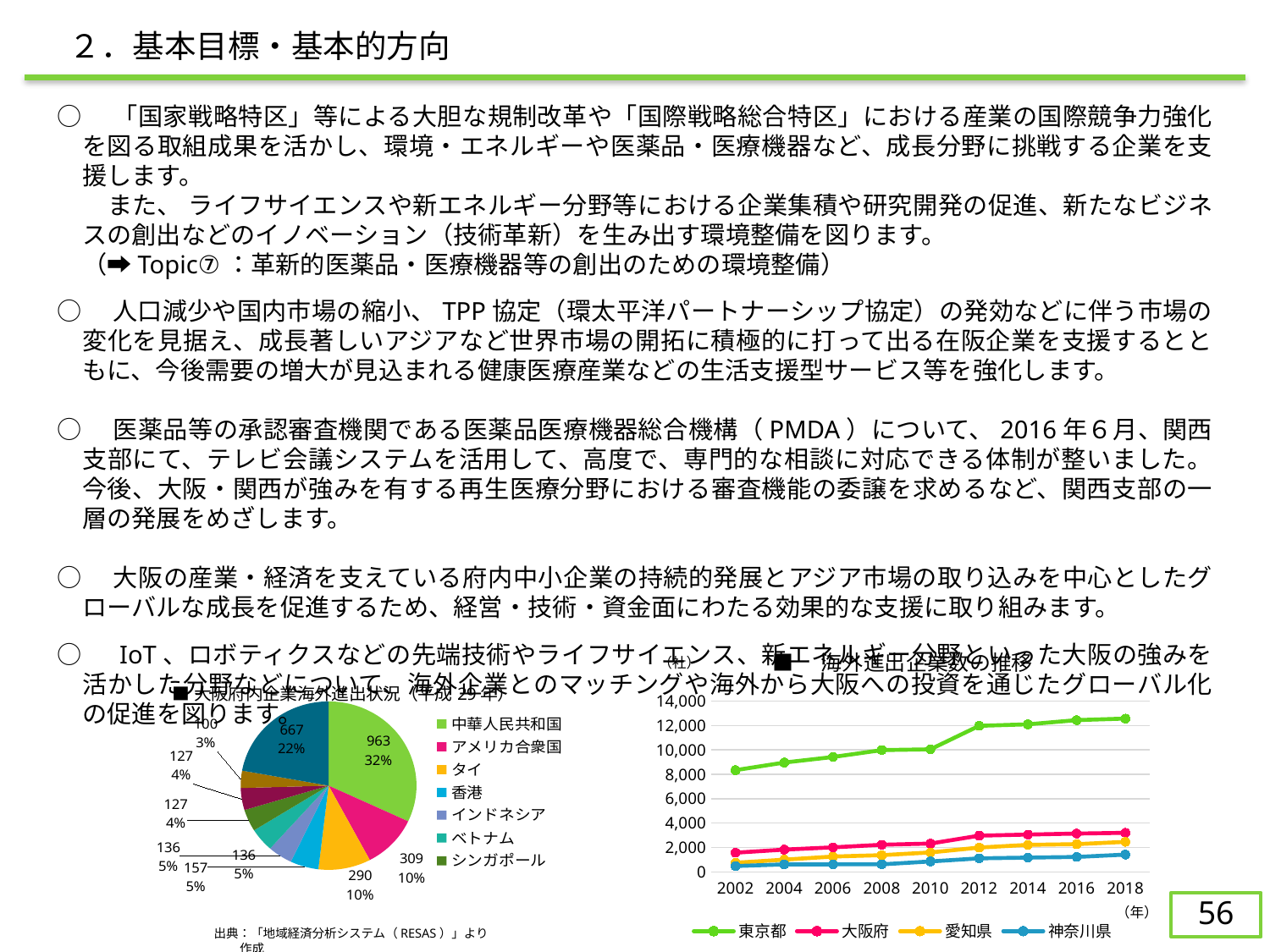
How many series does the legend of the chart 海外進出企業数の推移 list? 4 In the pie chart 大阪府内企業海外進出状況（平成25年）, what is the value for アメリカ合衆国? 309 In the chart 海外進出企業数の推移, is the value for 東京都 in 2018 greater or less than 12,000? greater In the chart 海外進出企業数の推移, do the values for 東京都 rise or fall from 2002 to 2018? rise In the chart 海外進出企業数の推移, which prefecture has the lowest values throughout? 神奈川県 In the chart 海外進出企業数の推移, which prefecture has the highest values throughout? 東京都 What kind of chart is the right chart titled 海外進出企業数の推移? line chart In the pie chart 大阪府内企業海外進出状況（平成25年）, which country has the largest slice? 中華人民共和国 What kind of chart is the left chart titled 大阪府内企業海外進出状況（平成25年）? pie chart In the pie chart 大阪府内企業海外進出状況（平成25年）, what share of the pie does 中華人民共和国 have? 32% In the pie chart 大阪府内企業海外進出状況（平成25年）, what is the value for タイ? 290 In the pie chart 大阪府内企業海外進出状況（平成25年）, what is the value for 中華人民共和国? 963